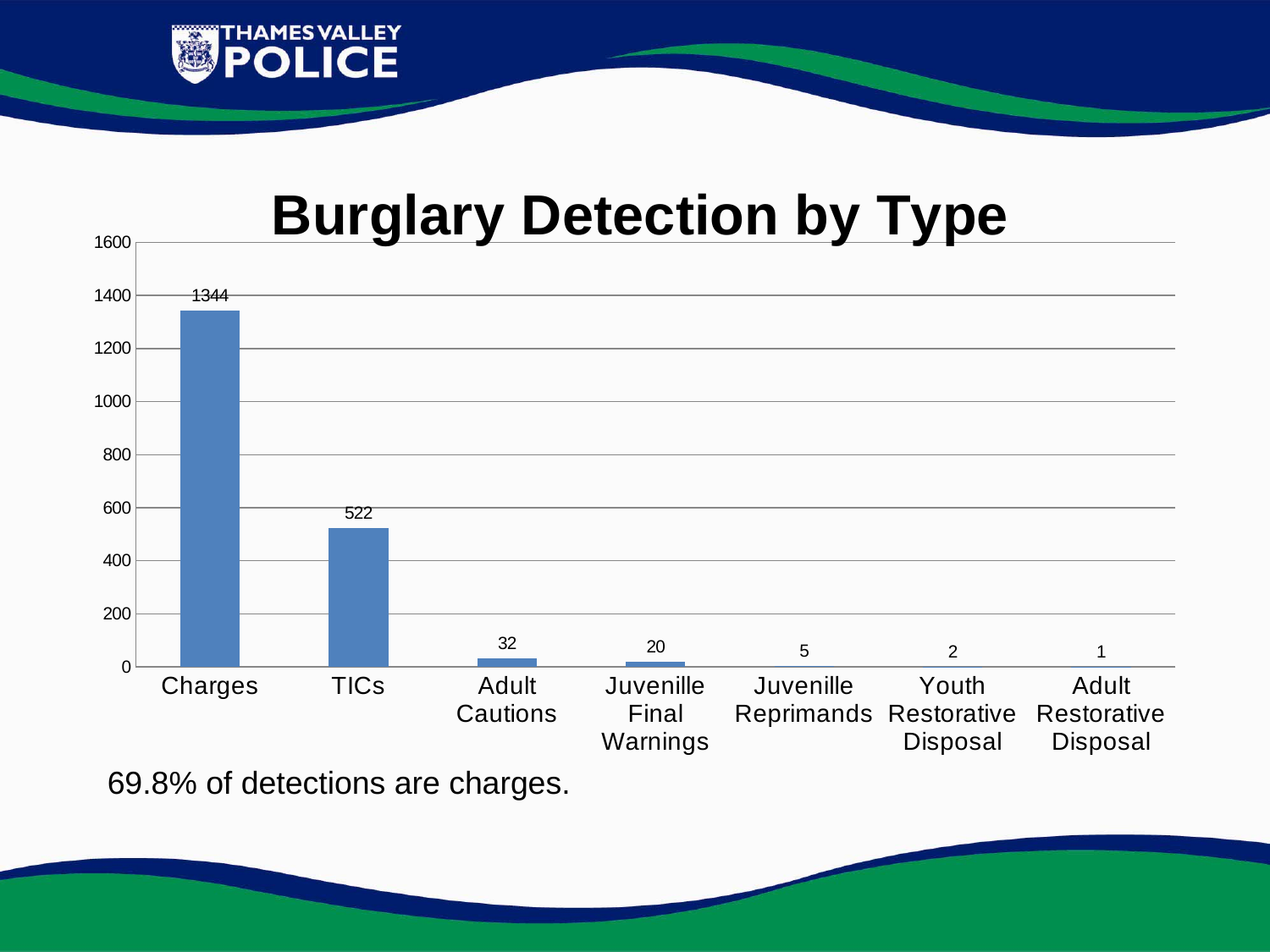
What is the value for Charges? 1344 Which category has the highest value? Charges Which category has the lowest value? Adult Restorative Disposal What is the value for Adult Cautions? 32 What kind of chart is shown on the slide? bar chart What is the title of the chart? Burglary Detection by Type What is the value for Juvenille Final Warnings? 20 How many categories are shown on the x axis? 7 Which is larger, the value for Juvenille Reprimands or the value for Youth Restorative Disposal? Juvenille Reprimands What is the difference between the values for Charges and TICs? 822 Is the value for TICs greater or less than 600? less What is the value for TICs? 522